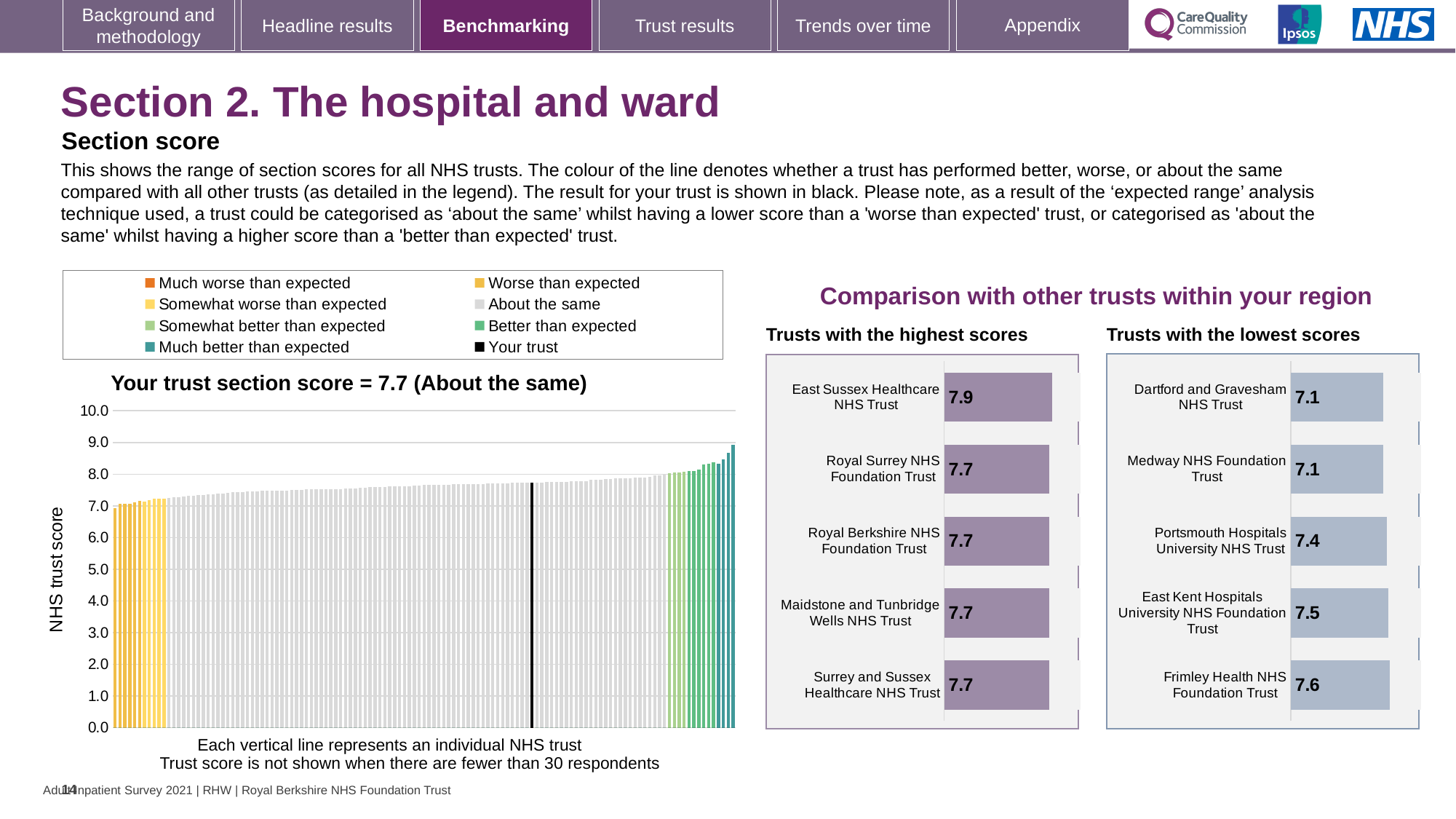
What is the y-axis label of the 'Your trust section score' chart on the left? NHS trust score In the 'Trusts with the lowest scores' chart, what is the difference between the scores of Frimley Health NHS Foundation Trust and Dartford and Gravesham NHS Trust? 0.5 In the 'Trusts with the lowest scores' chart, which trust has the highest score shown? Frimley Health NHS Foundation Trust What type of chart is the 'Your trust section score' chart on the left? Bar chart In the 'Your trust section score' chart on the left, do the bars rise or fall from left to right? Rise In the 'Trusts with the lowest scores' chart, what is the score for Portsmouth Hospitals University NHS Trust? 7.4 In the 'Trusts with the highest scores' chart, which trust has the highest score? East Sussex Healthcare NHS Trust How many entries does the legend above the left-hand chart list? 8 In the 'Trusts with the lowest scores' chart, which has the larger score: Portsmouth Hospitals University NHS Trust or East Kent Hospitals University NHS Foundation Trust? East Kent Hospitals University NHS Foundation Trust In the 'Trusts with the lowest scores' chart, what is the score for Frimley Health NHS Foundation Trust? 7.6 In the 'Trusts with the highest scores' chart, what is the score for East Sussex Healthcare NHS Trust? 7.9 How many trusts are listed in the 'Trusts with the highest scores' chart? 5